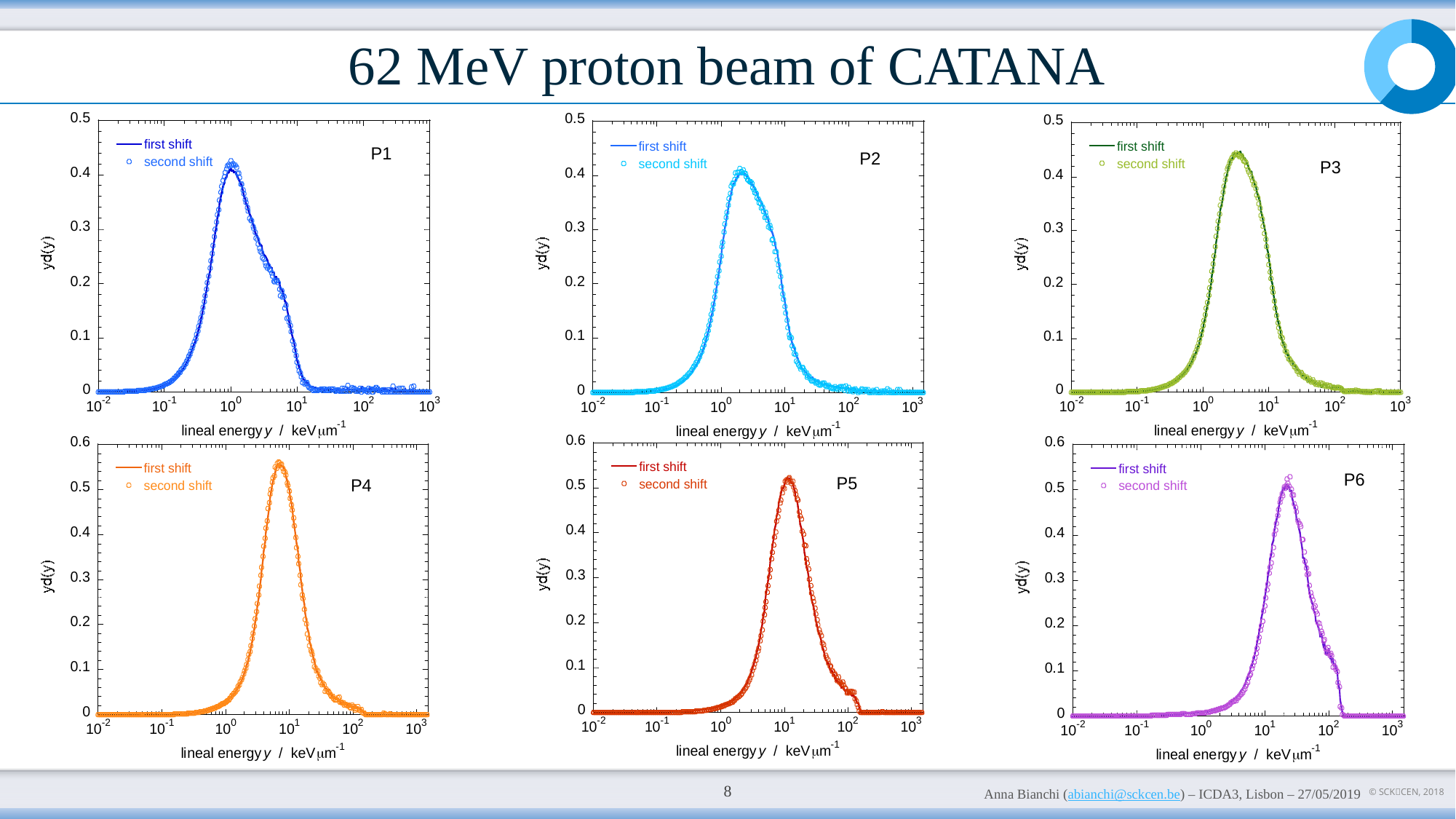
How many series does the legend list in the P1 chart? 2 What kind of chart is the P3 chart? line chart with scatter points What is the label on the x axis of the P2 chart? lineal energy y / keV µm^-1 In the P6 chart, is the peak value of yd(y) greater or less than 0.6? less What are the two legend entries in the P4 chart? first shift, second shift In the P4 chart, is the peak value of yd(y) greater or less than 0.5? greater Which chart has the higher peak value of yd(y), P4 or P1? P4 In the P6 chart, is the lineal energy at which the peak occurs greater or less than 10^1 keV/µm? greater Which chart has the higher peak value of yd(y), P3 or P4? P4 In the P4 chart, do the values rise or fall as lineal energy increases from 10^1 to 10^2? fall